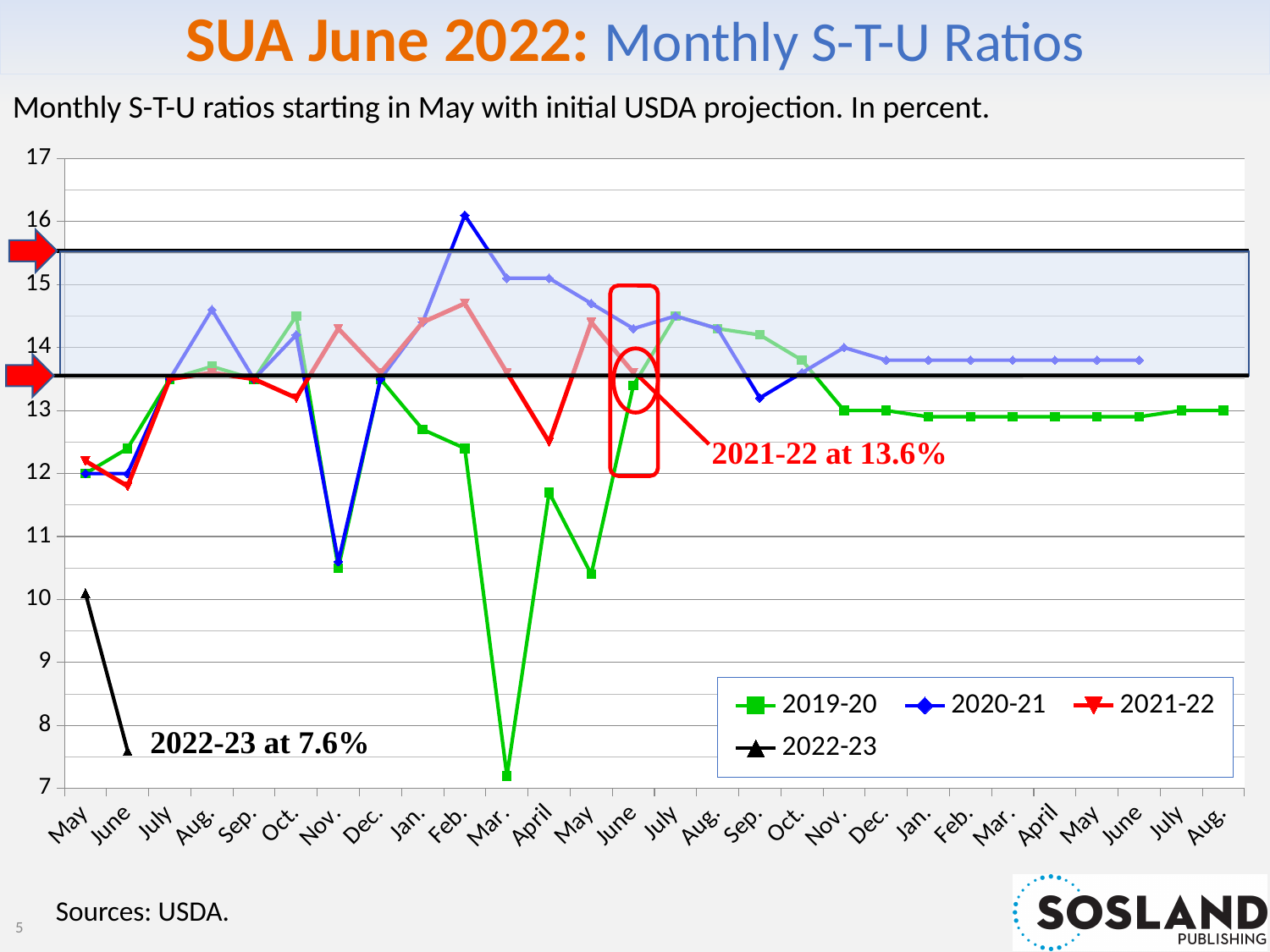
What kind of chart is shown on the slide? line chart What is the 2021-22 S-T-U ratio for June, as annotated on the chart? 13.6% Is the 2022-23 value for May greater or less than 9? greater How many series does the legend list? 4 Which series reaches the lowest value on the chart? 2019-20 Does the 2022-23 series rise or fall from May to June? fall Which series is drawn in red? 2021-22 Which series reaches the highest value on the chart? 2020-21 What is the 2022-23 S-T-U ratio for June, as annotated on the chart? 7.6%